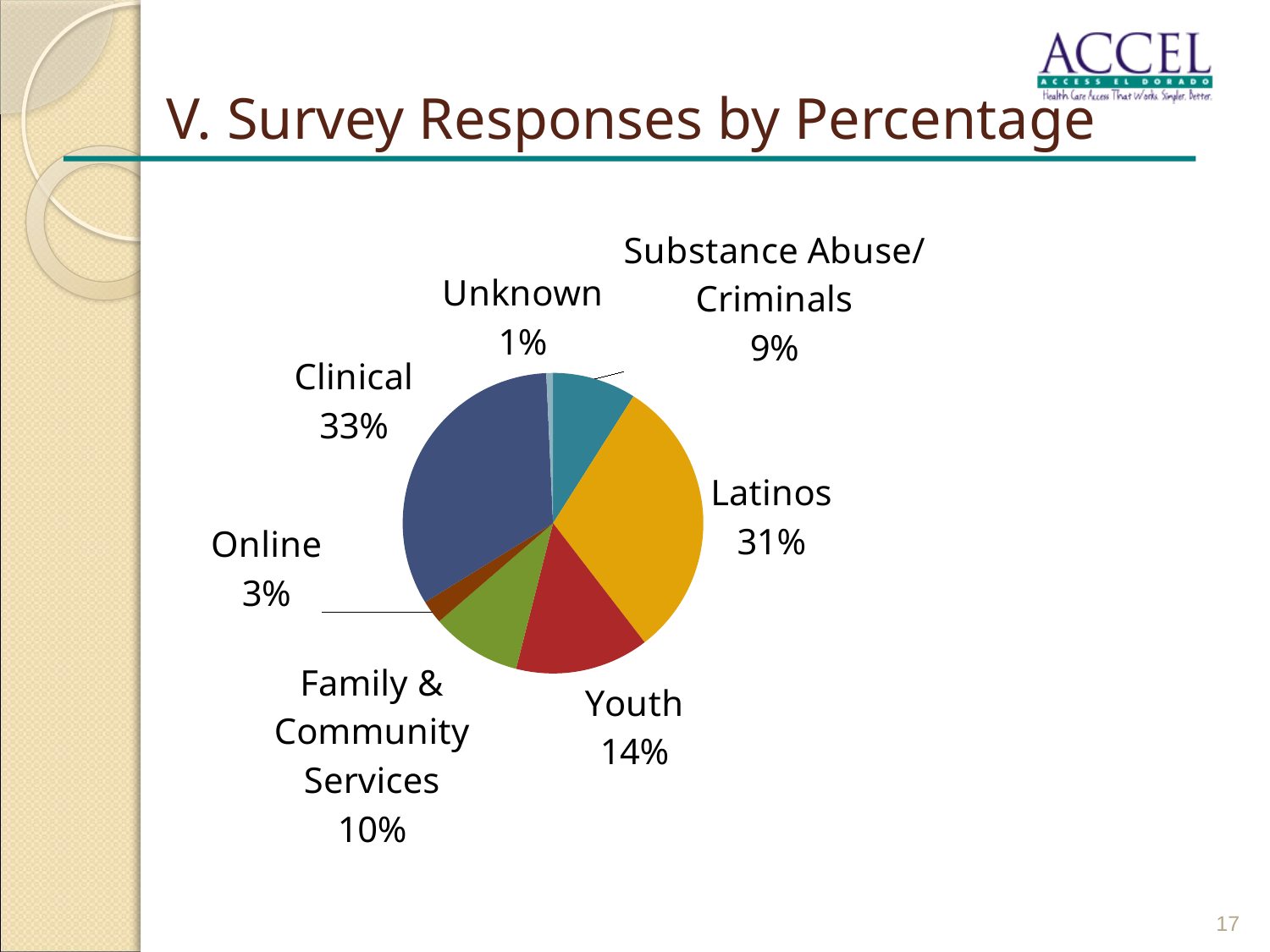
What percentage of survey responses came from Family & Community Services? 10% What percentage of survey responses came from Substance Abuse/Criminals? 9% How many categories are shown in the pie chart? 7 What percentage of survey responses came from Youth? 14% What kind of chart is shown on the slide? Pie chart Which category has the largest share of survey responses? Clinical What percentage of survey responses came from Online? 3% What percentage of survey responses came from Clinical? 33% What percentage of survey responses came from Latinos? 31% What is the difference in percentage points between Latinos and Youth? 17 Which category has the smallest share of survey responses? Unknown Which has a larger share of responses, Family & Community Services or Substance Abuse/Criminals? Family & Community Services